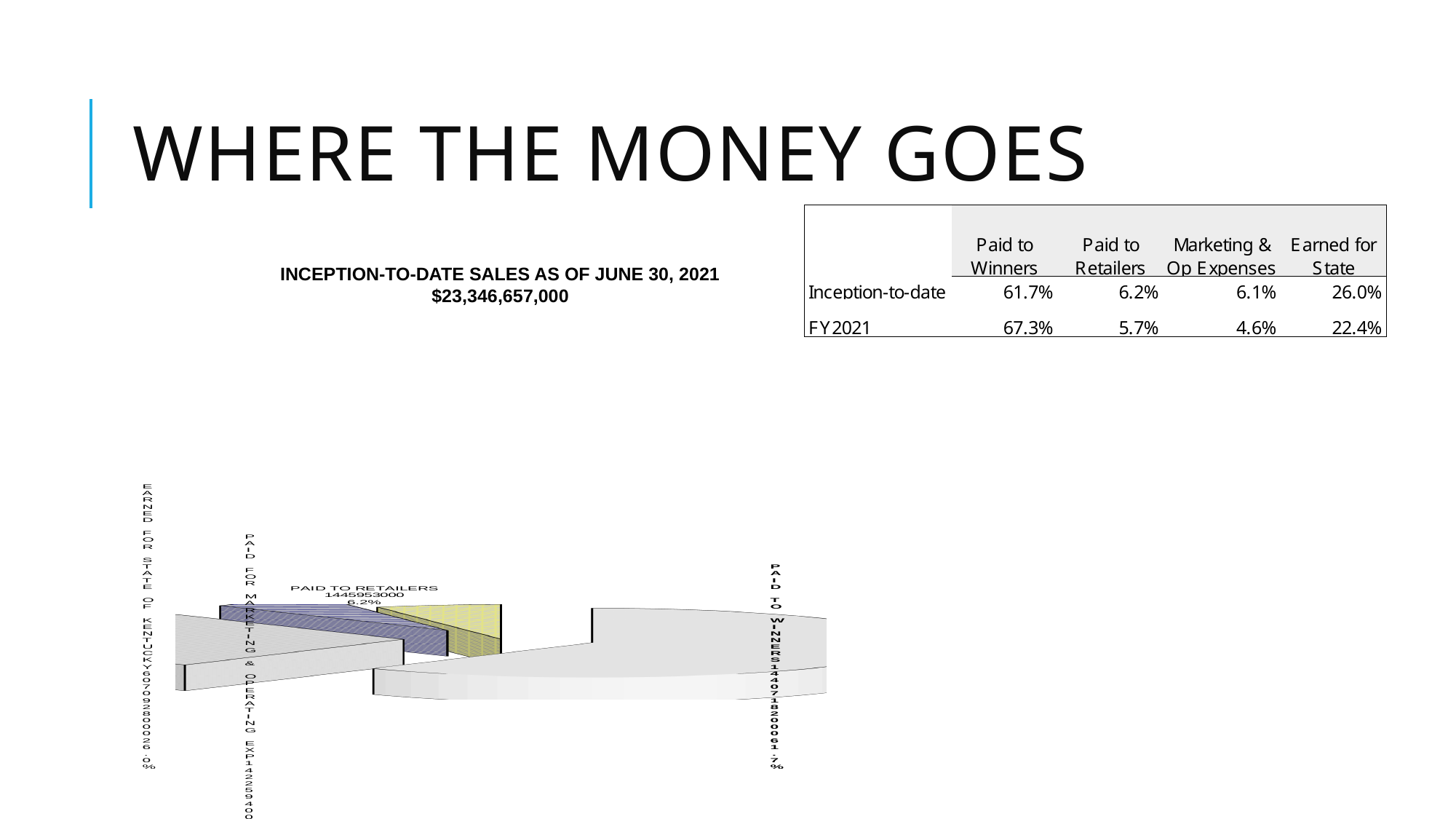
What is the difference in percentage points between the Paid to Winners share and the Earned for State of Kentucky share? 35.7% Which is larger in the pie chart, Paid to Winners or Earned for State of Kentucky? Paid to Winners What percentage share does the pie chart show for Earned for State of Kentucky? 26.0% How many slices does the pie chart have? 4 What is the title of the pie chart? INCEPTION-TO-DATE SALES AS OF JUNE 30, 2021 What kind of chart is shown on the slide? pie chart What dollar amount is labelled on the Paid to Retailers slice? 1445953000 What total sales figure is shown beneath the chart title? $23,346,657,000 What percentage share does the pie chart show for Paid to Retailers? 6.2% What is the difference in percentage points between the Earned for State of Kentucky share and the Paid to Retailers share? 19.8% What percentage share does the pie chart show for Paid to Winners? 61.7% Which slice of the pie chart is the largest? Paid to Winners